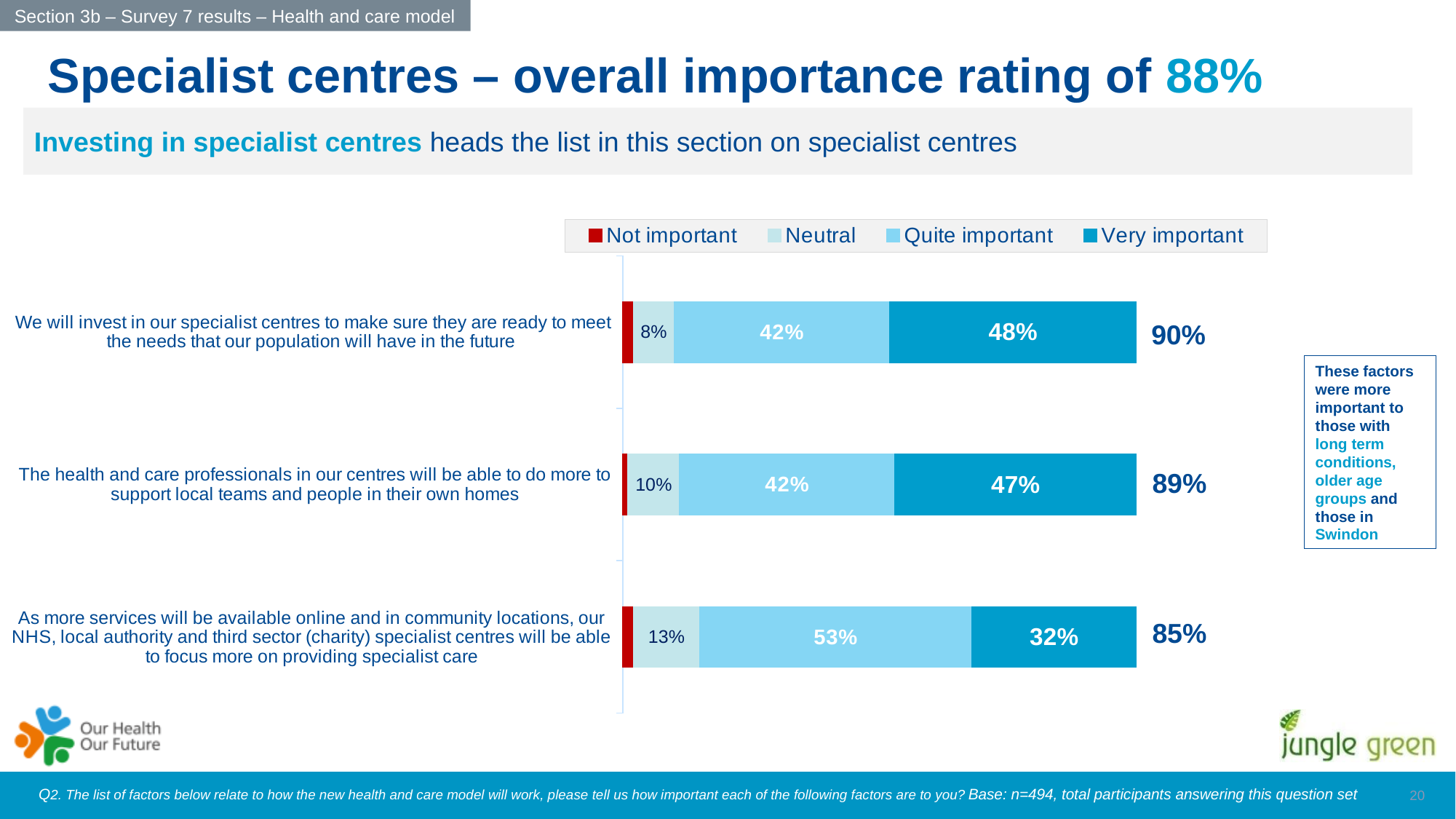
How many statements (categories) are plotted in the chart? 3 What is the 'Neutral' value for 'The health and care professionals in our centres will be able to do more to support local teams and people in their own homes'? 10% Which statement has the lowest 'Very important' value? As more services will be available online and in community locations, our NHS, local authority and third sector (charity) specialist centres will be able to focus more on providing specialist care What is the combined importance total shown to the right of the bar for 'The health and care professionals in our centres will be able to do more to support local teams and people in their own homes'? 89% What kind of chart is shown on the slide? Stacked bar chart Which statement has the highest 'Very important' value? We will invest in our specialist centres to make sure they are ready to meet the needs that our population will have in the future Which legend entry is shown in red? Not important What is the 'Very important' value for 'We will invest in our specialist centres to make sure they are ready to meet the needs that our population will have in the future'? 48% What is the difference between the 'Very important' values for the first statement (48%) and the third statement (32%)? 16% What is the 'Quite important' value for 'As more services will be available online and in community locations, our NHS, local authority and third sector (charity) specialist centres will be able to focus more on providing specialist care'? 53% Which is larger: the 'Quite important' value for the third statement or the 'Quite important' value for the first statement? The third statement (53%) How many series does the legend list? 4